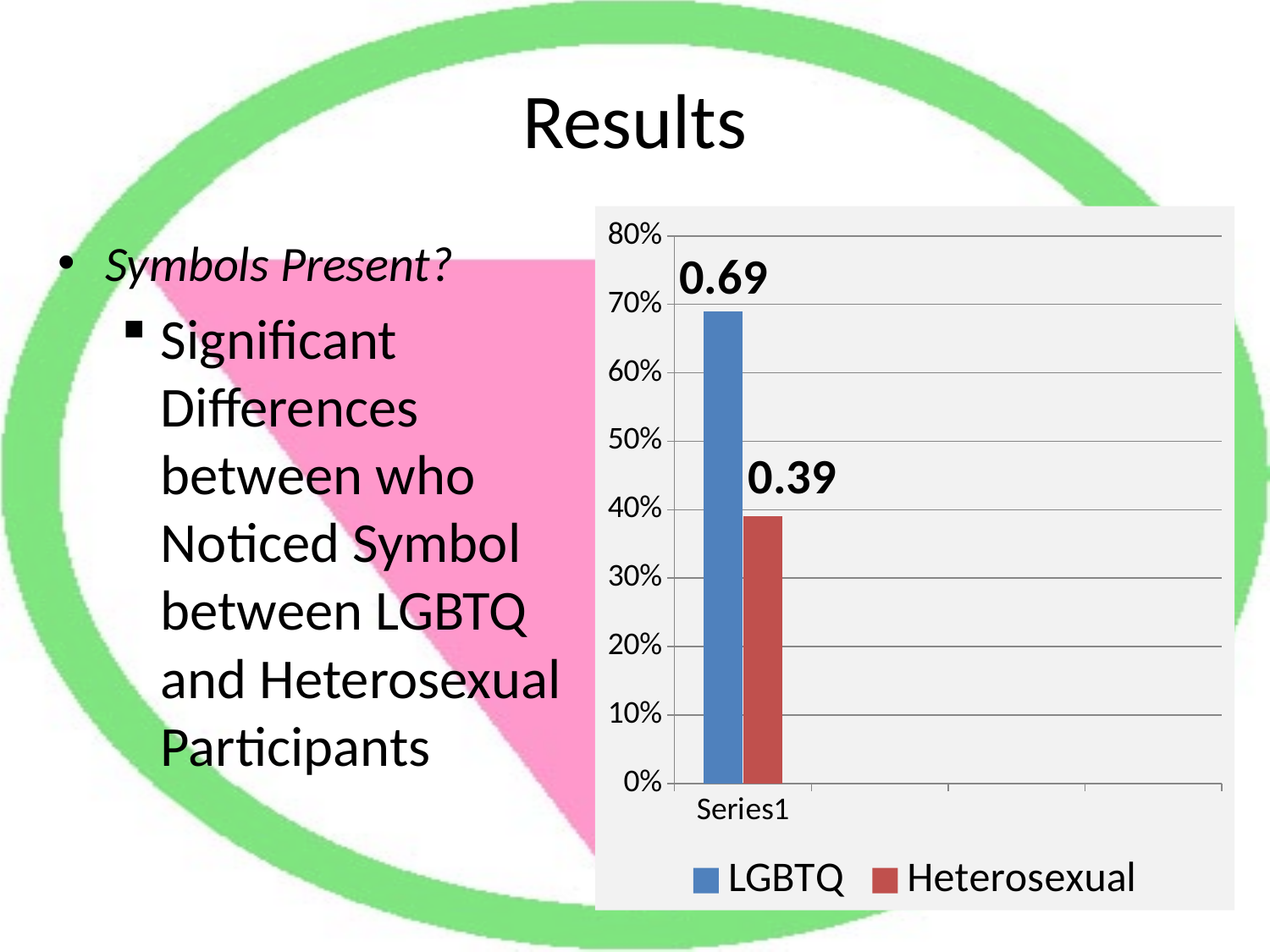
What kind of chart is shown? bar chart How many series does the legend list? 2 Is the value for LGBTQ greater or less than 60%? greater Is the value for Heterosexual greater or less than 40%? less Which series has the lowest value? Heterosexual What colour is the bar for Heterosexual? red What is the highest value shown on the y axis? 80% Which series has the higher value, LGBTQ or Heterosexual? LGBTQ What is the category label on the x axis? Series1 What is the value for LGBTQ? 0.69 What is the difference between the LGBTQ and Heterosexual values? 0.30 What is the value for Heterosexual? 0.39